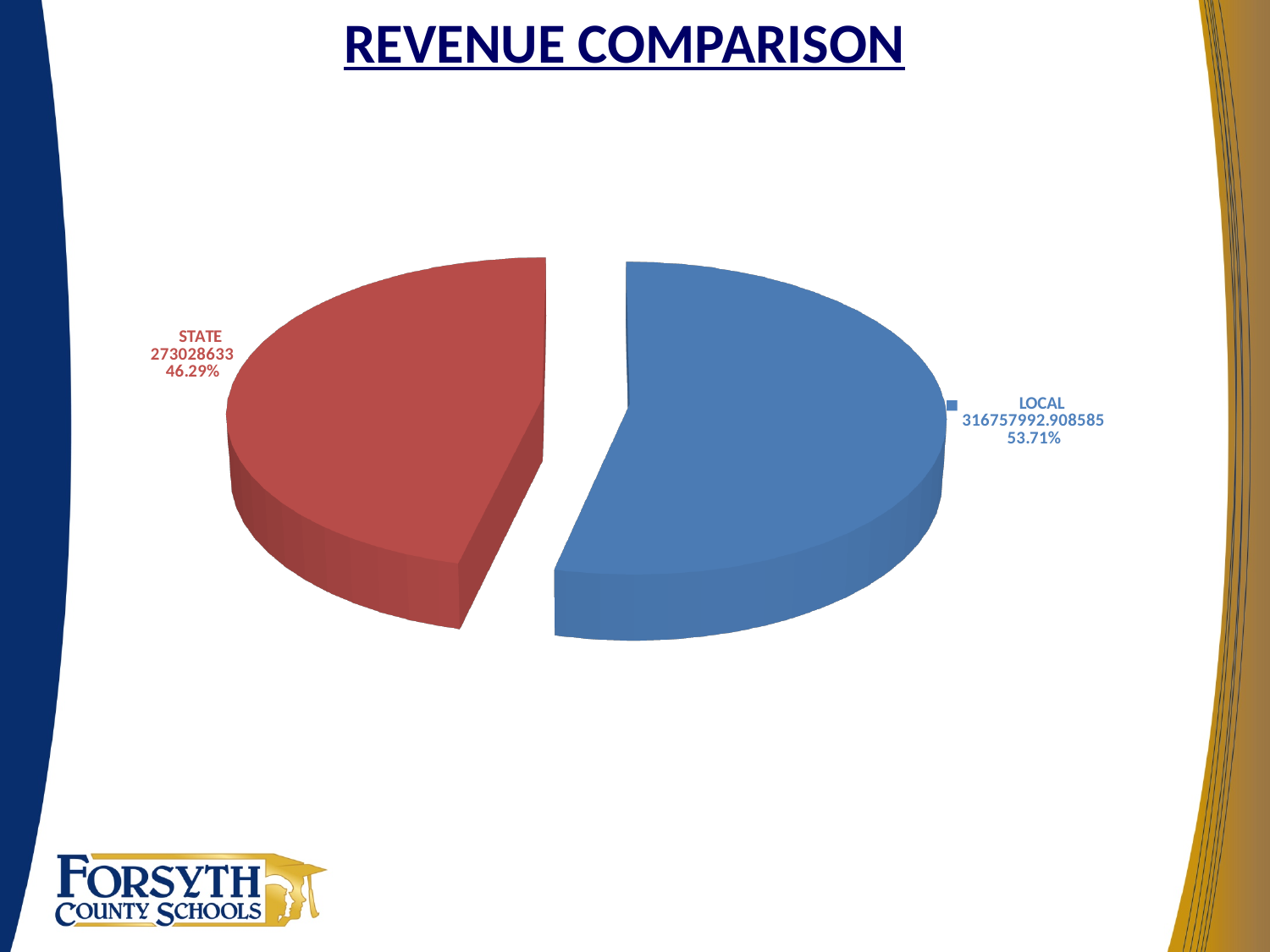
What kind of chart is shown on the slide? pie chart How many slices does the pie chart have? 2 What is the value shown for LOCAL? 316757992.908585 What is the title of the chart? REVENUE COMPARISON Which is larger, the share for LOCAL or the share for STATE? LOCAL What is the difference in percentage points between the LOCAL share and the STATE share? 7.42 Which category has the largest slice of the pie? LOCAL What is the value shown for STATE? 273028633 What percentage share of the pie does STATE represent? 46.29% Which category has the smallest slice of the pie? STATE What percentage share of the pie does LOCAL represent? 53.71% What colour is the STATE slice? red